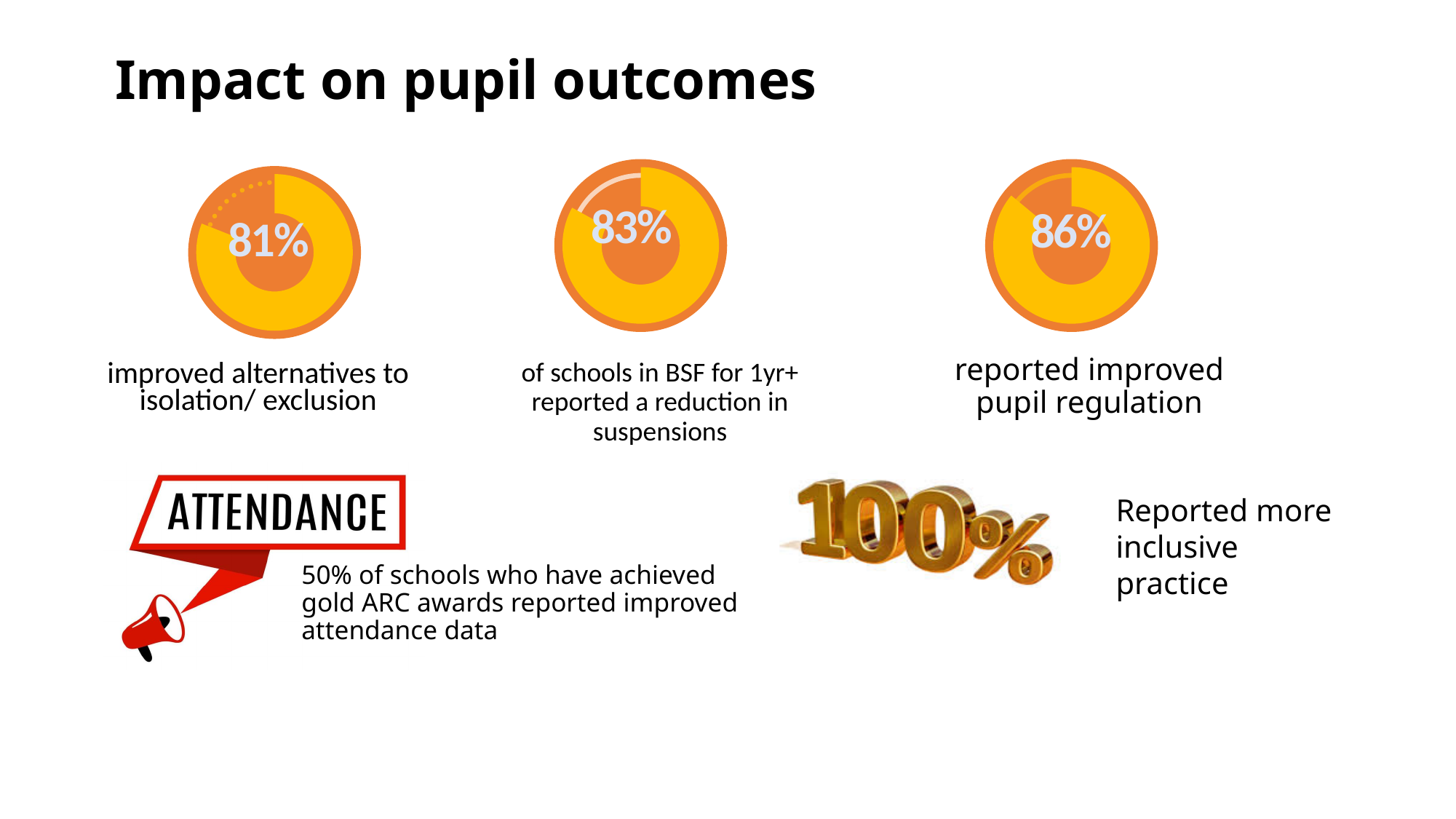
What is the difference between the percentage for improved pupil regulation and the percentage for improved alternatives to isolation/exclusion? 5% Is the percentage in the left chart (improved alternatives to isolation/exclusion) greater or less than 80%? greater Which of the three circular charts shows the lowest percentage? improved alternatives to isolation/exclusion (81%) How many circular percentage charts are shown on the slide? 3 What is the difference between the middle chart's percentage (reduction in suspensions) and the left chart's percentage (alternatives to isolation/exclusion)? 2% What percentage is shown in the right chart, for reported improved pupil regulation? 86% What percentage of schools in BSF for 1yr+ reported a reduction in suspensions, according to the middle chart? 83% What kind of chart is used to display the 81%, 83% and 86% figures? pie (donut) chart What percentage is shown in the left chart, for improved alternatives to isolation/exclusion? 81% Which is larger: the percentage reporting a reduction in suspensions or the percentage reporting improved pupil regulation? improved pupil regulation Which of the three circular charts shows the highest percentage? reported improved pupil regulation (86%) What is the title of the slide containing the three percentage charts? Impact on pupil outcomes